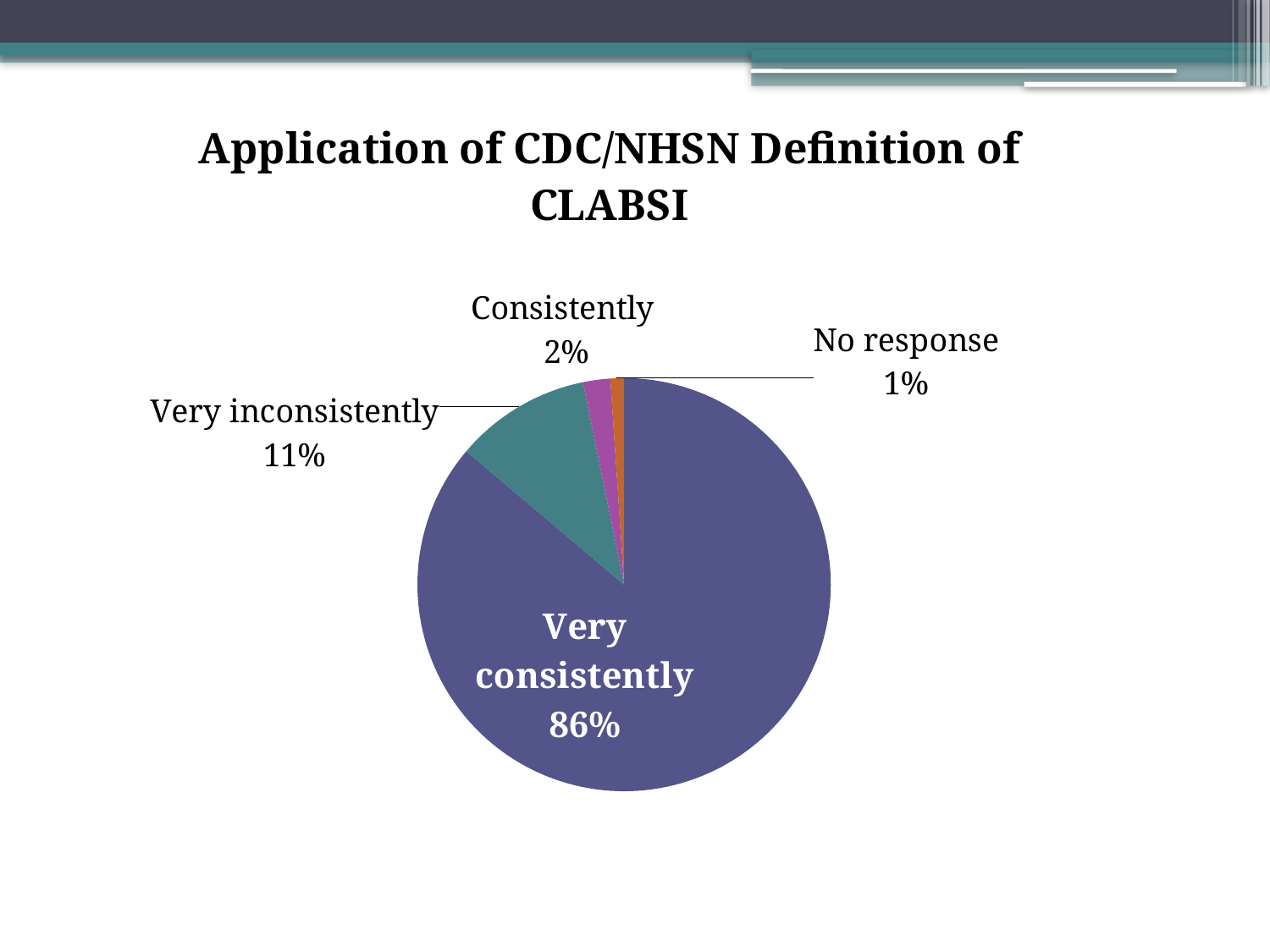
What share of the pie is labelled "No response"? 1% What share of the pie is labelled "Very consistently"? 86% How many slices does the pie chart have? 4 What share of the pie is labelled "Very inconsistently"? 11% What share of the pie is labelled "Consistently"? 2% Which category has the smallest slice of the pie? No response What is the difference in percentage points between "Very consistently" and "Very inconsistently"? 75 What is the title of the chart? Application of CDC/NHSN Definition of CLABSI Which is larger, the "Very inconsistently" slice or the "Consistently" slice? Very inconsistently What kind of chart is shown on the slide? pie chart What colour is the "Very inconsistently" slice? teal Which category has the largest slice of the pie? Very consistently